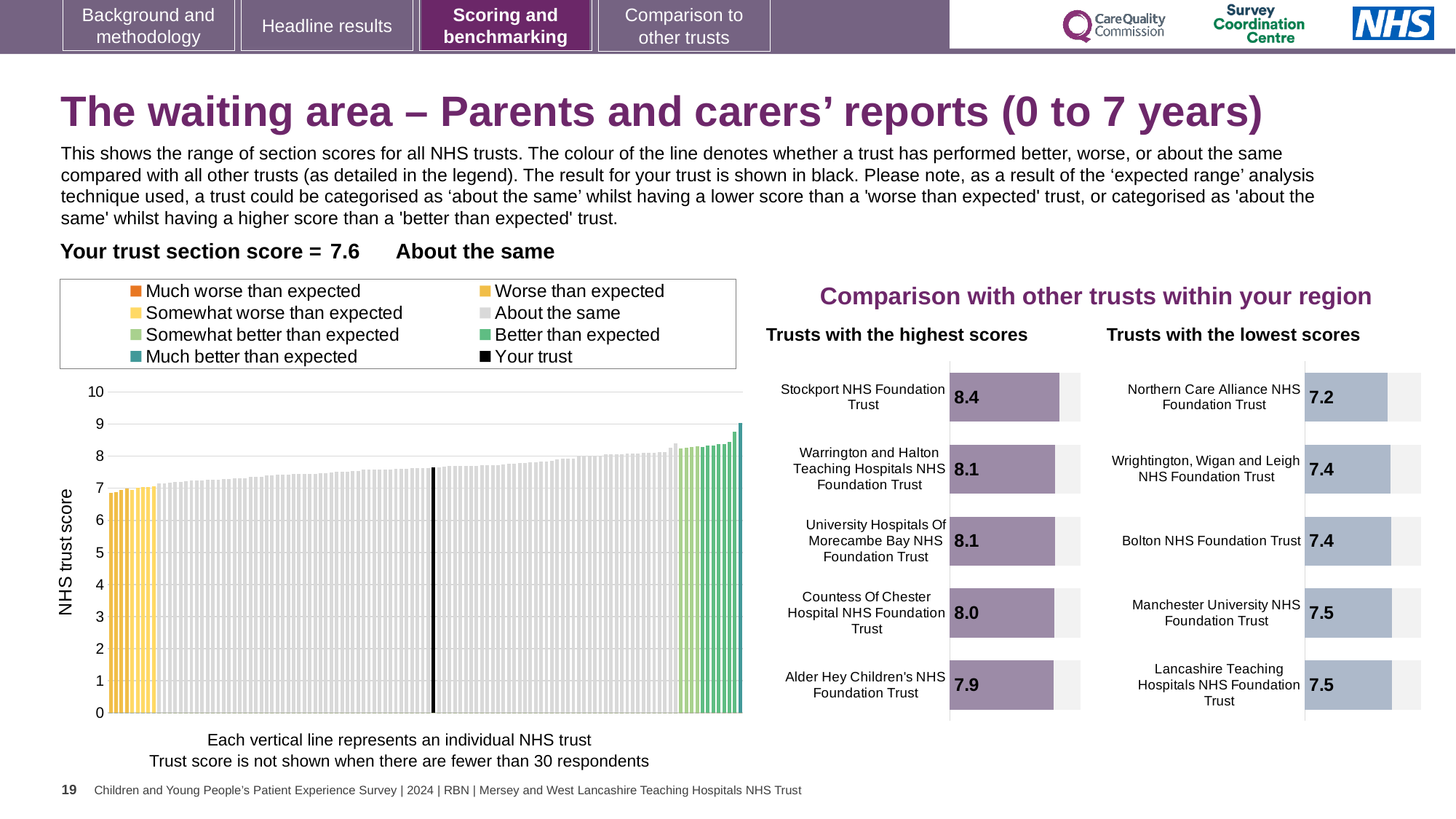
In the 'Trusts with the highest scores' chart, which trust has the highest score? Stockport NHS Foundation Trust In the 'Trusts with the highest scores' chart, what is the difference between the scores of Stockport NHS Foundation Trust and Countess Of Chester Hospital NHS Foundation Trust? 0.4 What kind of chart is the left-hand chart showing all NHS trust scores? Bar chart How many entries does the legend of the left-hand chart list? 8 In the 'Trusts with the highest scores' chart, what is the score for Stockport NHS Foundation Trust? 8.4 In the 'Trusts with the lowest scores' chart, what is the score for Northern Care Alliance NHS Foundation Trust? 7.2 In the 'Trusts with the highest scores' chart, what is the score for Alder Hey Children's NHS Foundation Trust? 7.9 In the left-hand chart of all NHS trusts, is the value for your trust (the black bar) greater or less than 7? greater In the 'Trusts with the lowest scores' chart, which has the larger score: Northern Care Alliance NHS Foundation Trust or Manchester University NHS Foundation Trust? Manchester University NHS Foundation Trust In the 'Trusts with the lowest scores' chart, what is the score for Bolton NHS Foundation Trust? 7.4 In the 'Trusts with the lowest scores' chart, which trust has the lowest score? Northern Care Alliance NHS Foundation Trust How many trusts are shown in the 'Trusts with the highest scores' chart? 5